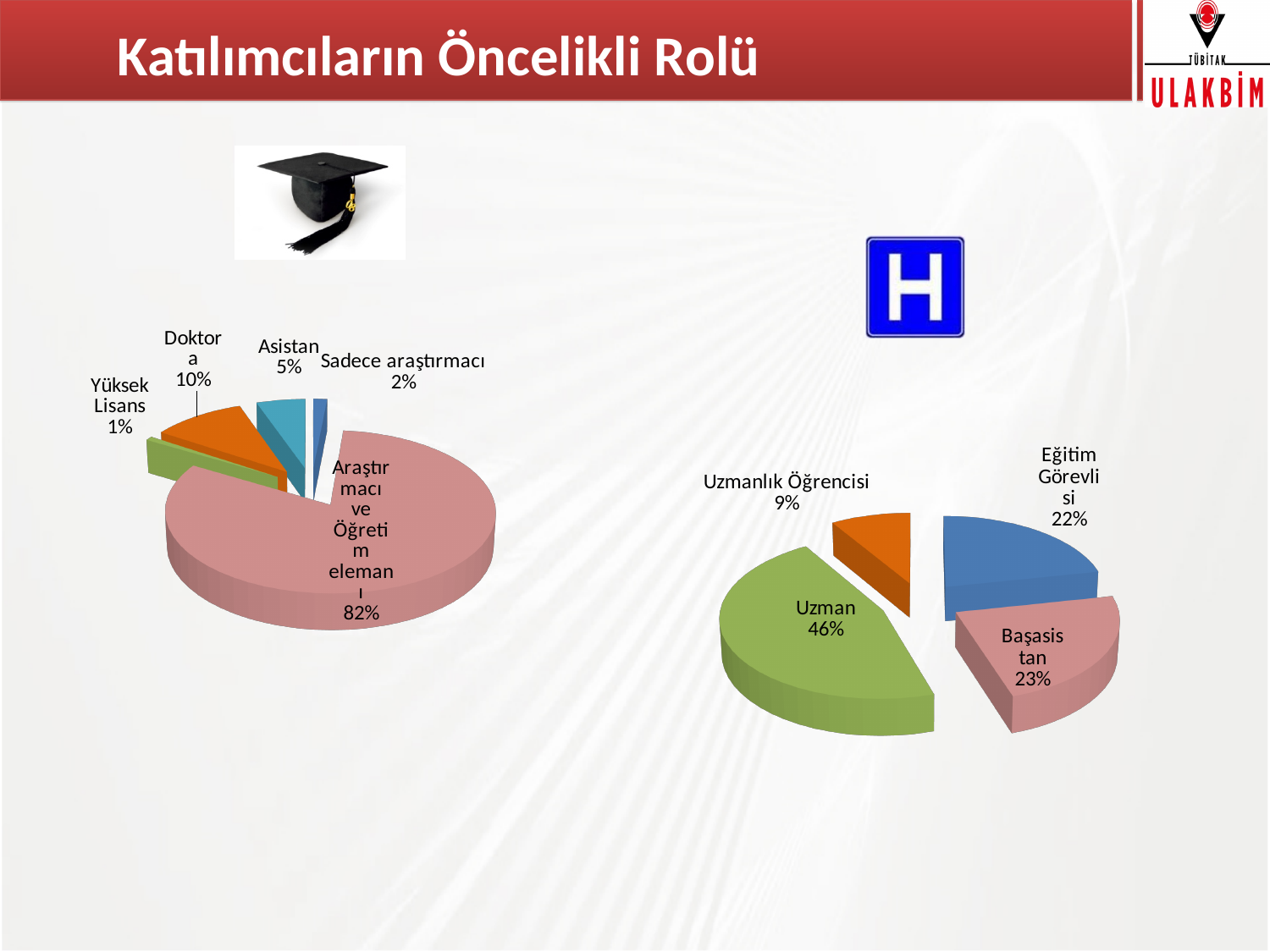
In the left pie chart, what share is labelled for Doktora? 10% In the right pie chart, what is the difference in percentage points between Başasistan and Eğitim Görevlisi? 1 In the left pie chart, what share is labelled for Araştırmacı ve Öğretim elemanı? 82% In the left pie chart, how many slices are there? 5 In the left pie chart, what is the difference in percentage points between Doktora and Asistan? 5 In the left pie chart, which category has the smallest share? Yüksek Lisans In the left pie chart, which is larger, Asistan or Sadece araştırmacı? Asistan In the right pie chart, which category has the largest share? Uzman In the right pie chart, what share is labelled for Uzman? 46% In the right pie chart, how many slices are there? 4 What type of chart is shown on the right side of the slide? Pie chart In the right pie chart, what share is labelled for Uzmanlık Öğrencisi? 9%